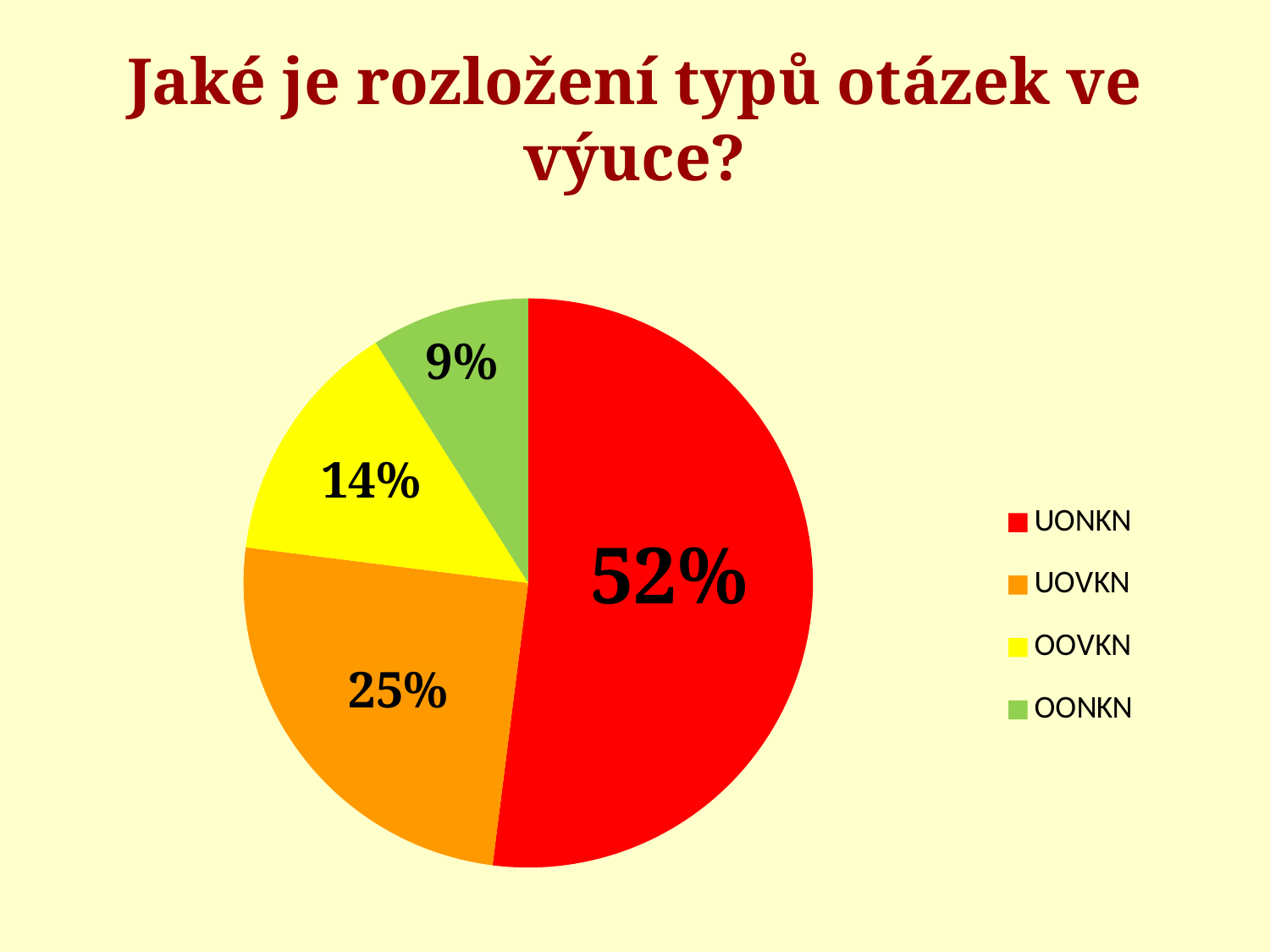
What is the difference in percentage points between OOVKN and OONKN? 5 What share of the pie does OONKN have? 9% What colour is the slice for OOVKN? yellow Which category has the smallest slice of the pie? OONKN What share of the pie does UONKN have? 52% What kind of chart is shown on the slide? pie chart How many categories does the legend list? 4 What share of the pie does UOVKN have? 25% Which is larger, the share for UOVKN or the share for OOVKN? UOVKN What is the difference in percentage points between UONKN and UOVKN? 27 Which category has the largest slice of the pie? UONKN